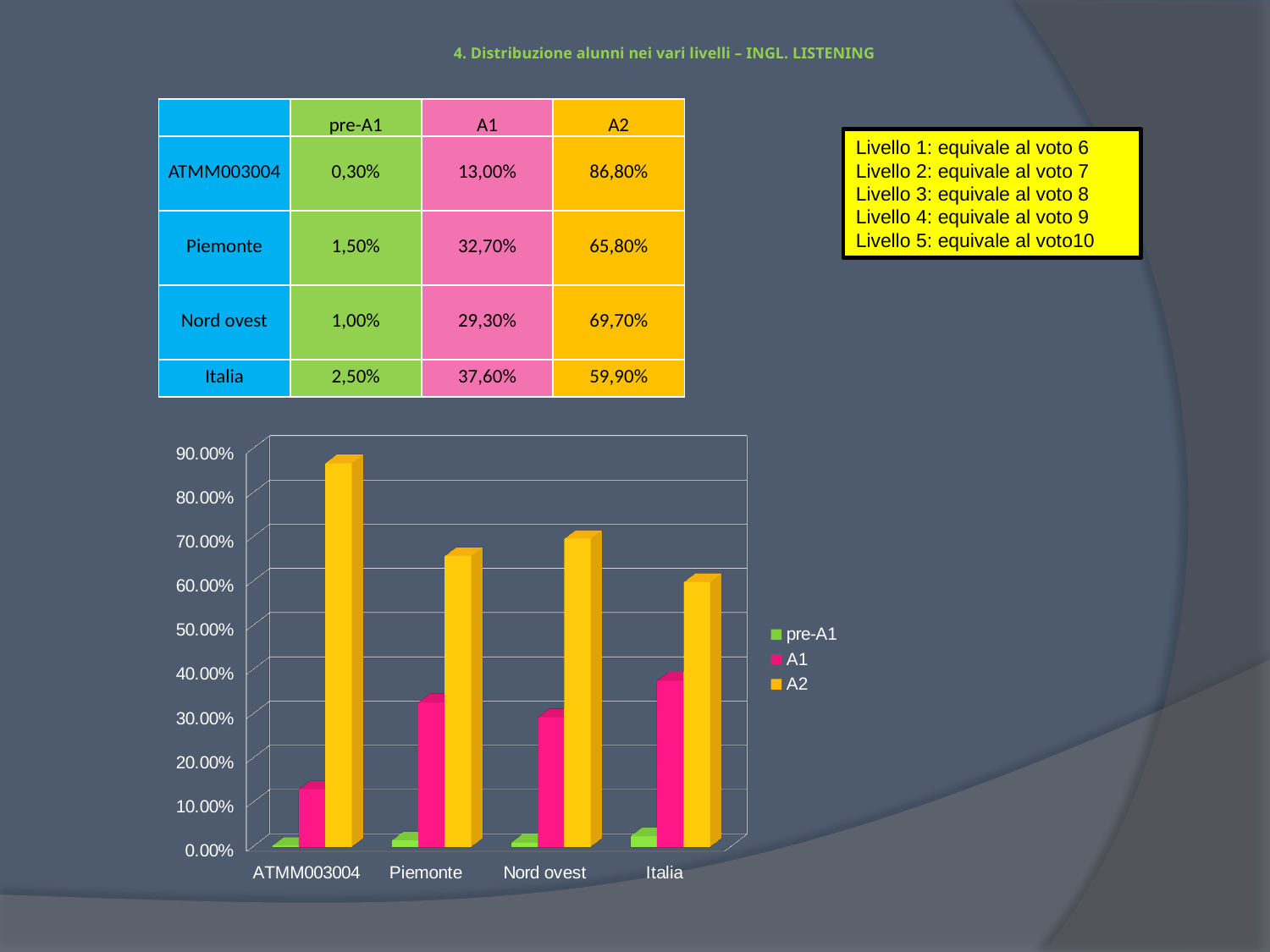
What kind of chart is shown on the slide? bar chart Which is larger in the chart: the A1 value for Nord ovest or the A1 value for Italia? Italia Is the A2 value for Nord ovest greater or less than 60.00%? greater Which category has the highest A1 value in the chart? Italia Which category has the highest A2 value in the chart? ATMM003004 How many categories are shown on the x axis of the chart? 4 Which category has the lowest A2 value in the chart? Italia Is the A1 value for Piemonte greater or less than 40.00%? less Which series in the chart legend is shown in green? pre-A1 Which category has the lowest A1 value in the chart? ATMM003004 How many series does the chart legend list? 3 Is the A2 value for ATMM003004 greater or less than 80.00%? greater